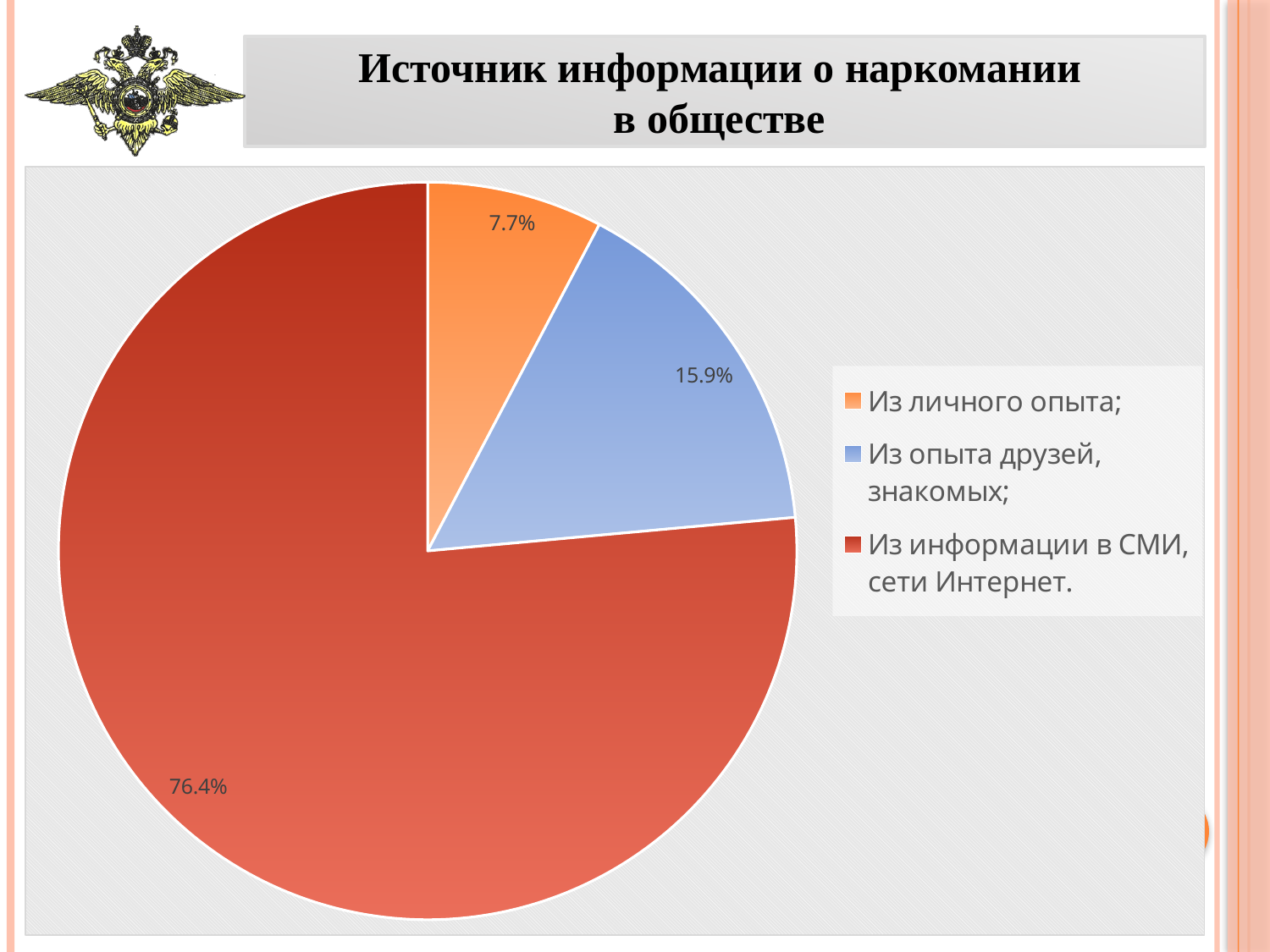
What share of the pie is labelled "Из информации в СМИ, сети Интернет."? 76.4% What is the difference in percentage points between "Из информации в СМИ, сети Интернет." and "Из опыта друзей, знакомых;"? 60.5 Which is larger: the slice for "Из опыта друзей, знакомых;" or the slice for "Из личного опыта;"? Из опыта друзей, знакомых; What is the title of the chart on the slide? Источник информации о наркомании в обществе Which category has the smallest slice of the pie? Из личного опыта; What is the difference in percentage points between "Из опыта друзей, знакомых;" and "Из личного опыта;"? 8.2 What colour is the slice for "Из опыта друзей, знакомых;"? blue What kind of chart is shown on the slide? pie chart What share of the pie is labelled "Из опыта друзей, знакомых;"? 15.9% How many categories does the pie chart have? 3 What share of the pie is labelled "Из личного опыта;"? 7.7% Which category has the largest slice of the pie? Из информации в СМИ, сети Интернет.